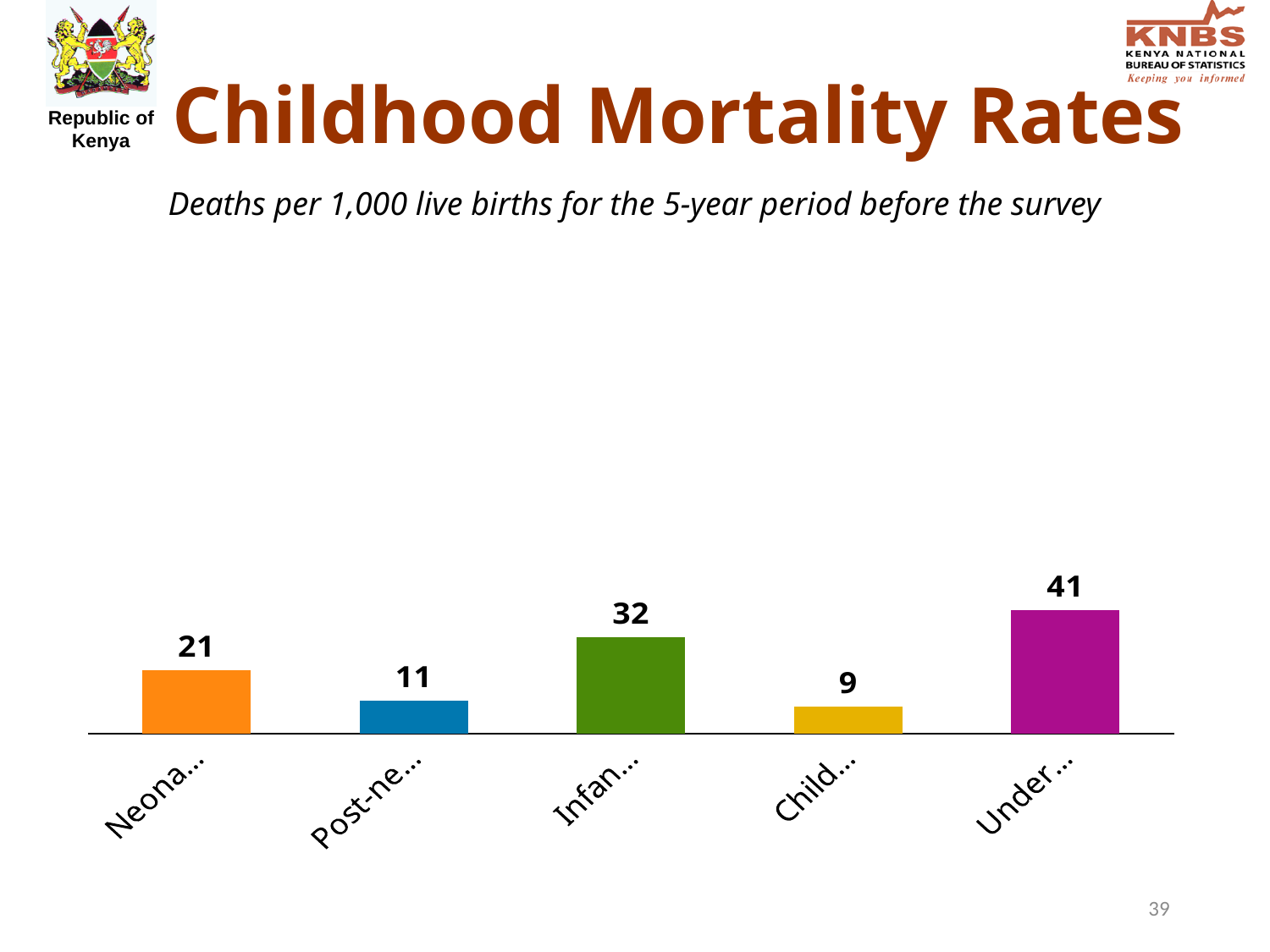
Which bar has the lowest value? Child… What is the value shown for the bar labelled "Post-ne…"? 11 What is the value shown for the last bar, labelled "Under…"? 41 Which bar has the highest value? Under… What is the value shown for the bar labelled "Child…"? 9 What is the title of the chart on the slide? Childhood Mortality Rates What is the value shown for the bar labelled "Infan…"? 32 What is the value shown for the first bar, labelled "Neona…"? 21 What type of chart is shown on the slide? bar chart What is the difference between the values for "Under…" and "Infan…"? 9 Which is larger, the value for "Neona…" or the value for "Post-ne…"? Neona… How many bars are plotted in the chart? 5